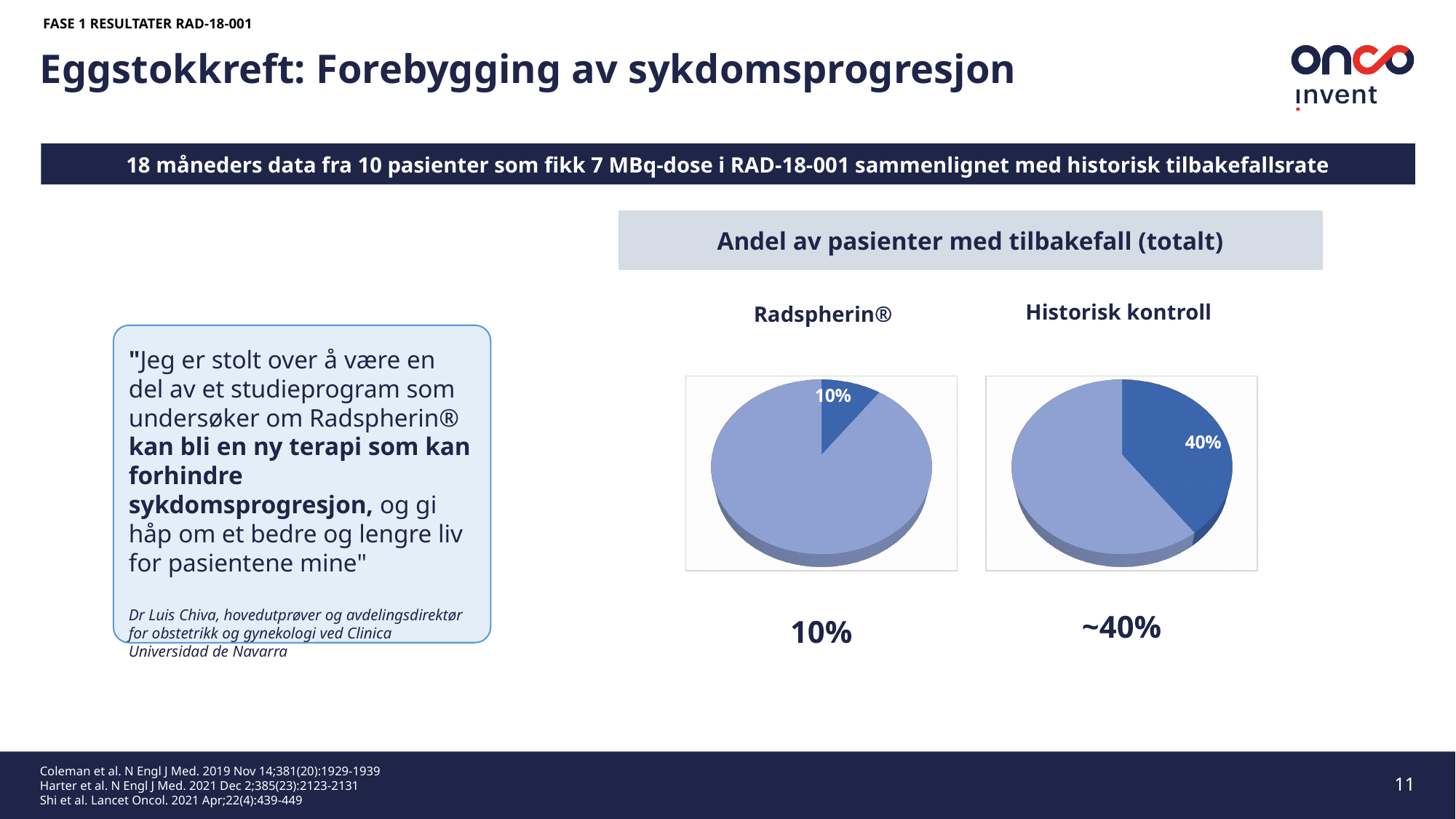
Which of the two pie charts shows the highest share of patients with relapse? Historisk kontroll How many slices does the Historisk kontroll pie chart have? 2 How many pie charts are shown on the slide? 2 In the Radspherin® pie chart, what percentage is printed on the dark blue slice? 10% Which of the two pie charts shows the lowest share of patients with relapse? Radspherin® What value is printed below the Historisk kontroll pie chart? ~40% What kind of chart is used under the heading "Andel av pasienter med tilbakefall (totalt)"? pie chart What is the difference in percentage points between the dark blue slice in the Historisk kontroll pie chart (40%) and the dark blue slice in the Radspherin® pie chart (10%)? 30 percentage points What is the title printed above the two pie charts? Andel av pasienter med tilbakefall (totalt) Which pie chart has the larger dark blue slice, Radspherin® or Historisk kontroll? Historisk kontroll In the Historisk kontroll pie chart, what percentage is printed on the dark blue slice? 40% What share of the Radspherin® pie chart does the dark blue slice represent? 10%